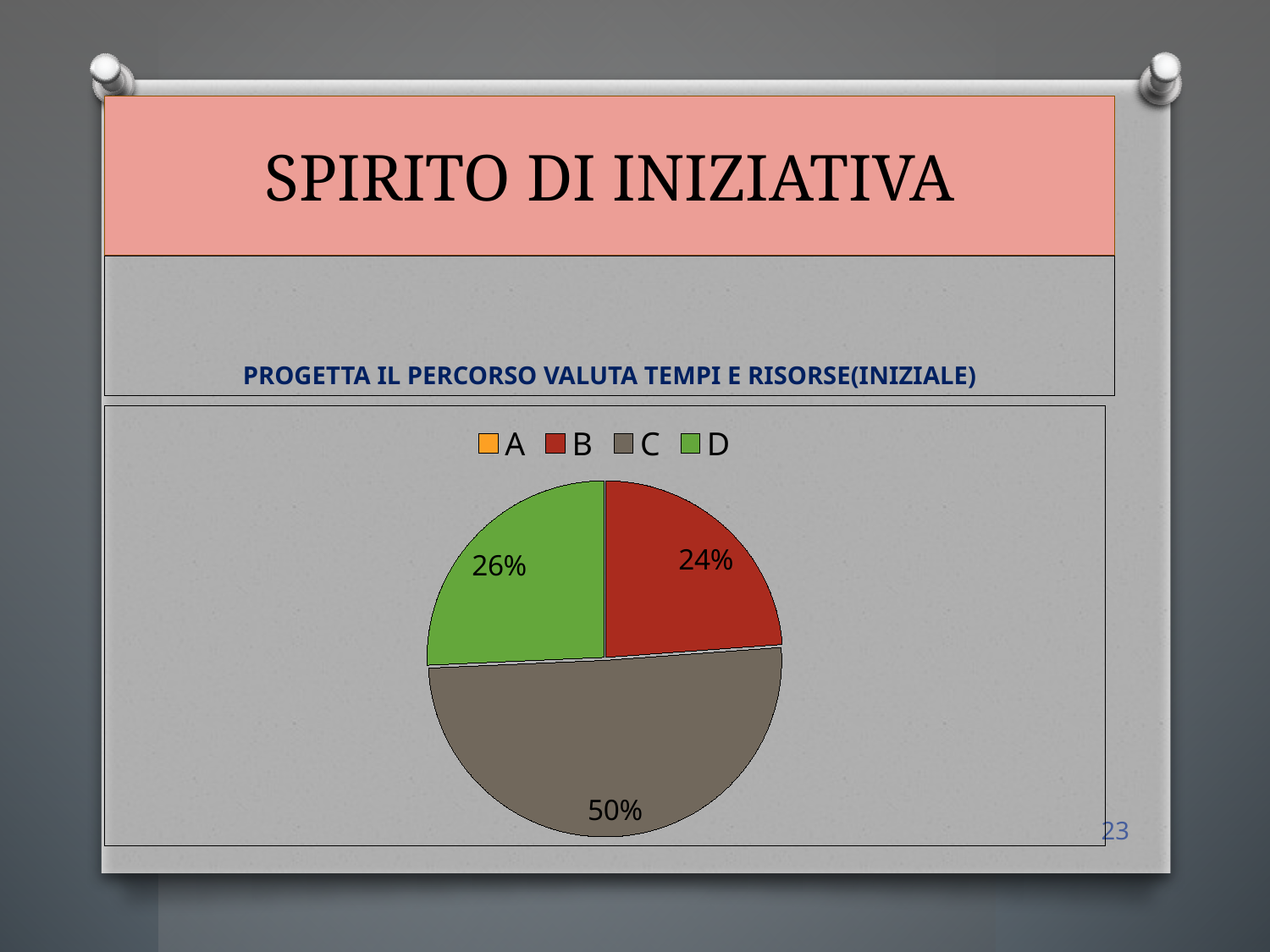
What percentage does slice D represent in the pie chart? 26% What is the difference between the percentages for D and B in the pie chart? 2% What is the title shown above the pie chart? PROGETTA IL PERCORSO VALUTA TEMPI E RISORSE(INIZIALE) Which category has the largest slice in the pie chart? C What share of the pie does slice C take up? 50% Which is larger in the pie chart, slice B or slice D? D What kind of chart is shown on the slide? Pie chart What is the difference between the percentages for C and B in the pie chart? 26% What colour is slice C in the pie chart? Grey How many entries does the legend of the pie chart list? 4 What percentage does slice C represent in the pie chart? 50% What percentage does slice B represent in the pie chart? 24%